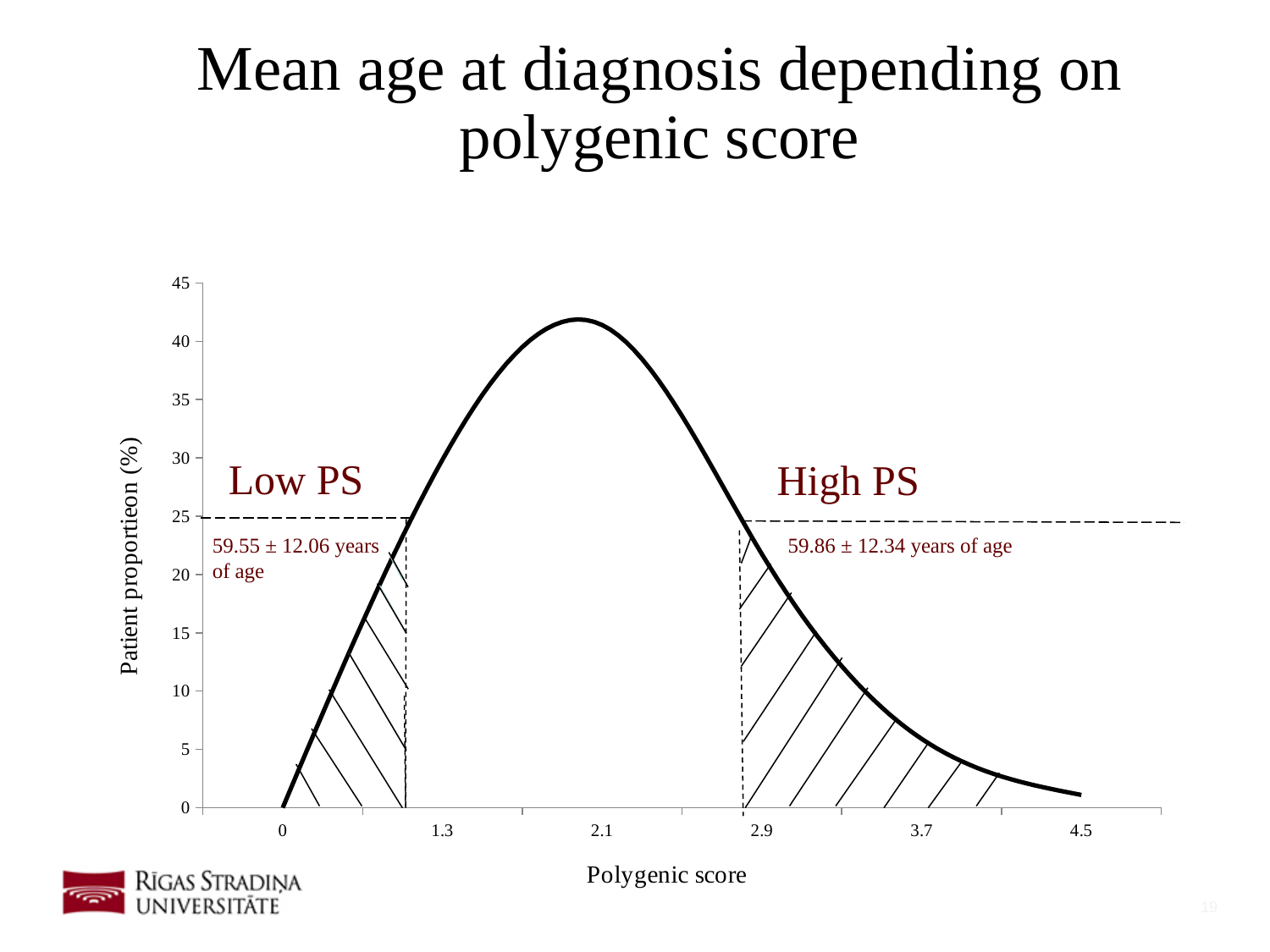
What mean age at diagnosis is given for the Low PS group? 59.55 ± 12.06 years of age What mean age at diagnosis is given for the High PS group? 59.86 ± 12.34 years of age Which group has the higher mean age at diagnosis, Low PS or High PS? High PS What kind of chart is shown on the slide? line chart What is the title of the chart on the slide? Mean age at diagnosis depending on polygenic score Is the peak patient proportion of the curve greater or less than 40? greater What is the label of the y axis? Patient proportieon (%) How many tick labels are shown on the polygenic score axis? 6 Is the patient proportion at a polygenic score of 4.5 greater or less than 5? less Does the patient proportion rise or fall as the polygenic score increases from 2.9 to 4.5? fall Is the patient proportion at a polygenic score of 3.7 greater or less than 10? less What is the difference between the mean age at diagnosis of the High PS group and the Low PS group? 0.31 years